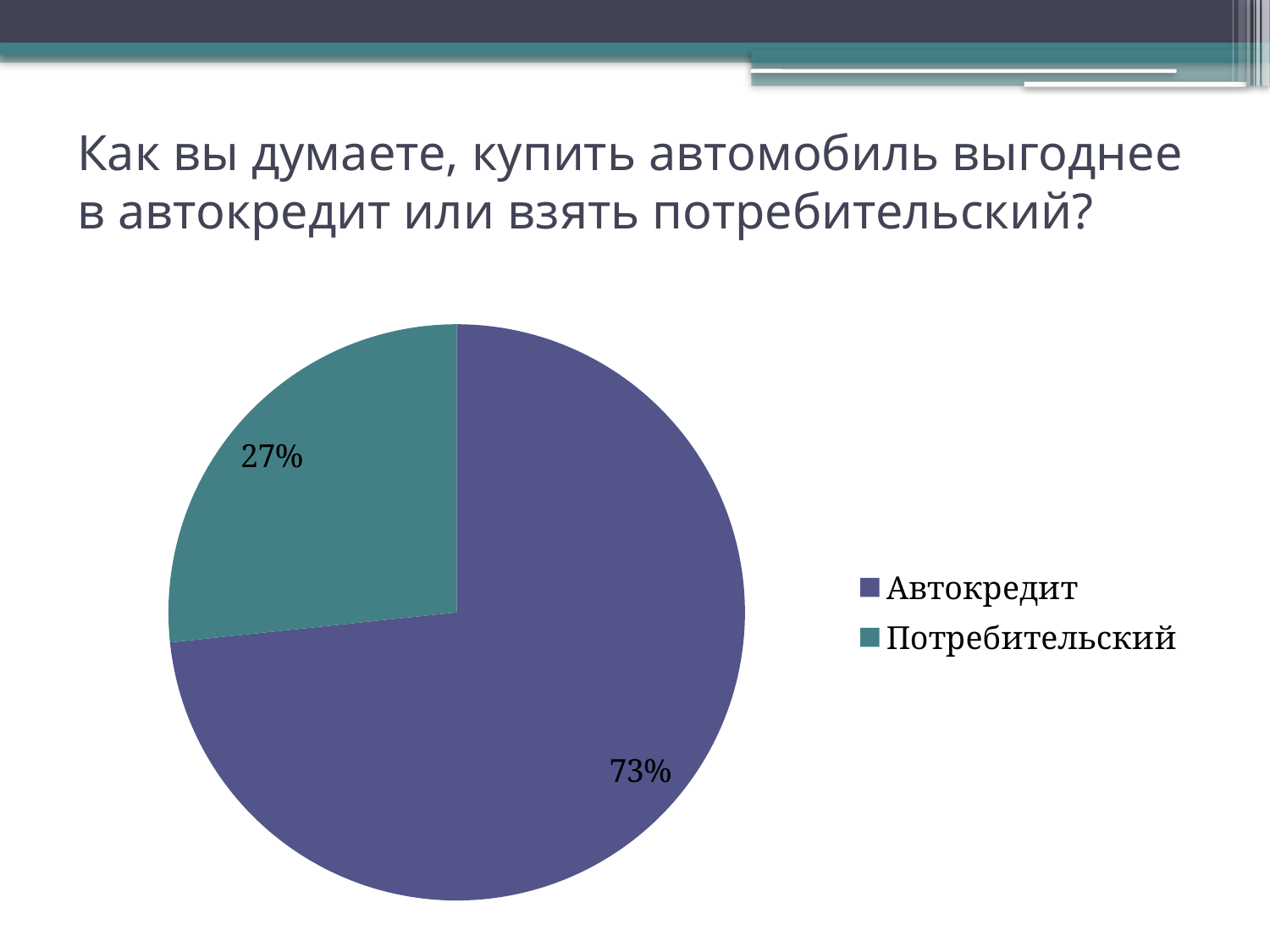
Which legend entry is shown in purple? Автокредит What is the difference in percentage points between the Автокредит and Потребительский slices? 46 What is the title of the slide above the chart? Как вы думаете, купить автомобиль выгоднее в автокредит или взять потребительский? Which slice is larger, Автокредит or Потребительский? Автокредит What kind of chart is shown on the slide? Pie chart How many entries does the legend list? 2 How many slices does the pie chart have? 2 Which category has the smallest slice of the pie? Потребительский Which category has the largest slice of the pie? Автокредит What share of the pie does Потребительский take? 27% What share of the pie does Автокредит take? 73% What is the value printed on the teal slice? 27%